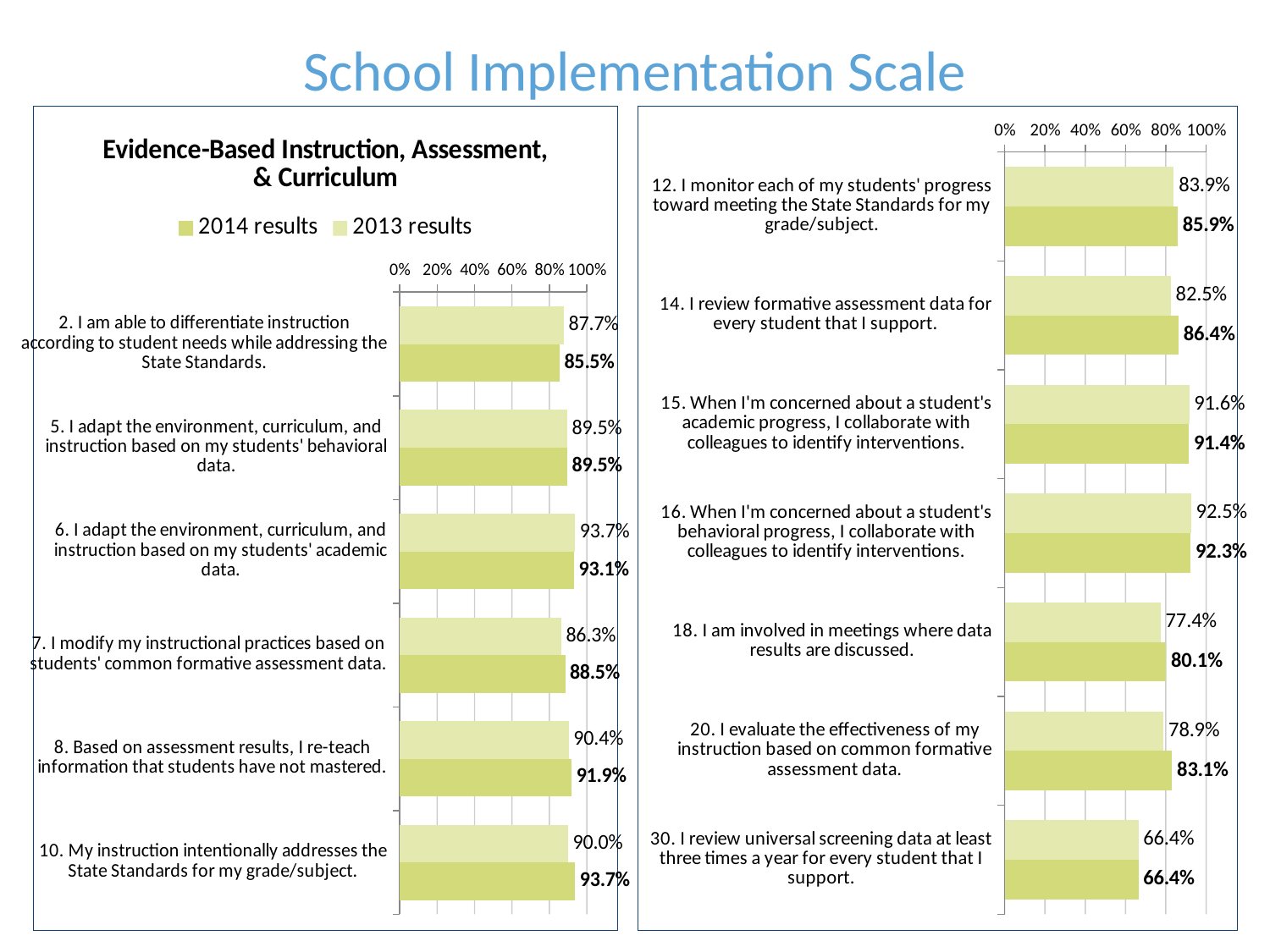
In the left chart titled 'Evidence-Based Instruction, Assessment, & Curriculum', which is larger for item 2: the 2013 result or the 2014 result? 2013 result In the left chart titled 'Evidence-Based Instruction, Assessment, & Curriculum', what is the difference between the 2014 and 2013 results for item 10? 3.7% What type of chart is the left chart titled 'Evidence-Based Instruction, Assessment, & Curriculum'? Bar chart In the right-hand chart, what is the difference between the 2014 and 2013 results for item 20, 'I evaluate the effectiveness of my instruction based on common formative assessment data'? 4.2% In the right-hand chart, what is the 2014 result for item 14, 'I review formative assessment data for every student that I support'? 86.4% In the right-hand chart, what is the 2013 result for item 18, 'I am involved in meetings where data results are discussed'? 77.4% In the left chart titled 'Evidence-Based Instruction, Assessment, & Curriculum', what is the 2013 result for item 7, 'I modify my instructional practices based on students' common formative assessment data'? 86.3% In the left chart titled 'Evidence-Based Instruction, Assessment, & Curriculum', which item has the highest 2013 result? 6. I adapt the environment, curriculum, and instruction based on my students' academic data. In the left chart titled 'Evidence-Based Instruction, Assessment, & Curriculum', what is the 2014 result for item 10, 'My instruction intentionally addresses the State Standards for my grade/subject'? 93.7% How many series does the legend of the left chart titled 'Evidence-Based Instruction, Assessment, & Curriculum' list? 2 In the right-hand chart, which item has the lowest 2014 result? 30. I review universal screening data at least three times a year for every student that I support. How many items (categories) are shown in the right-hand chart? 7